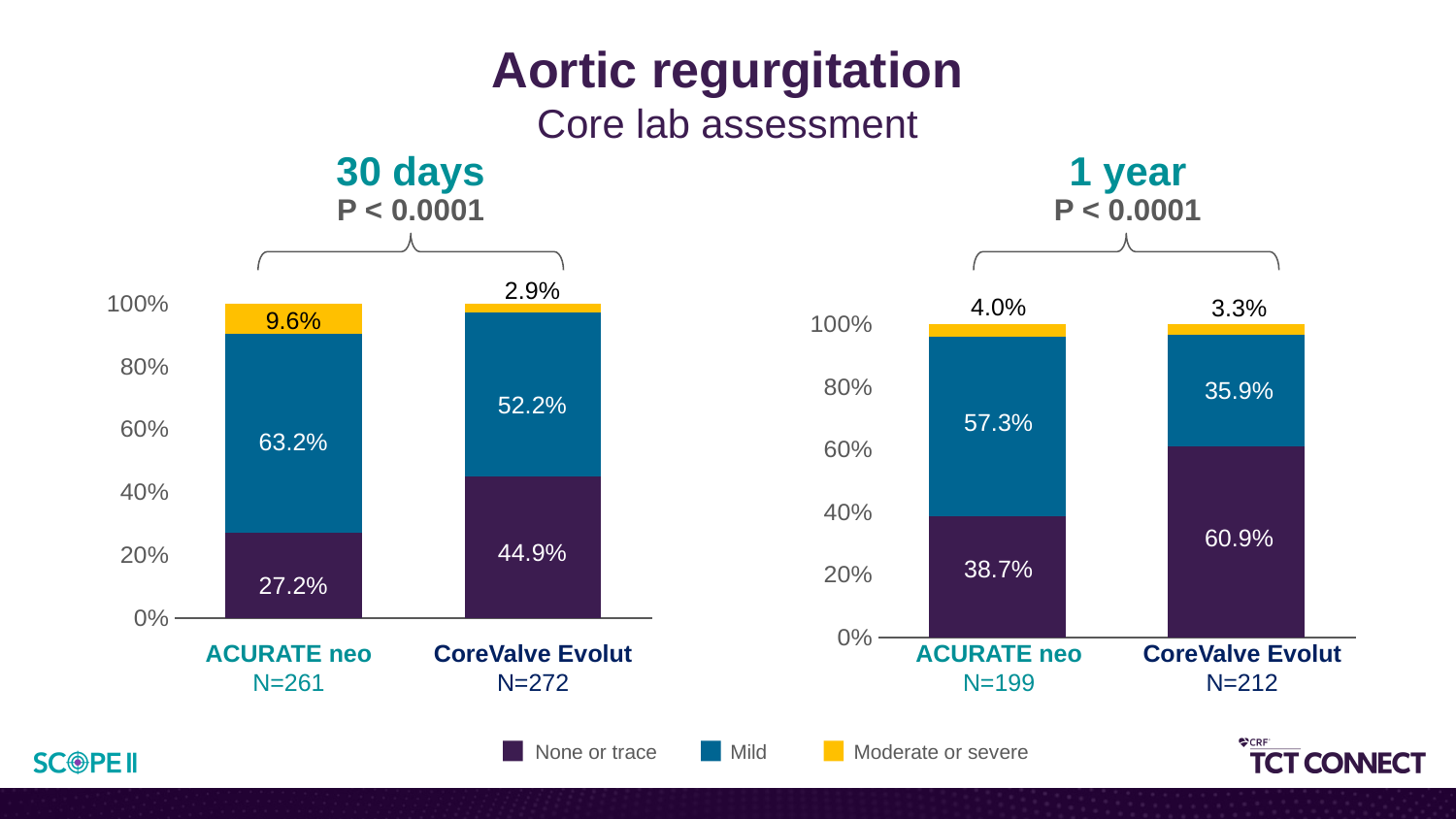
In the 1 year chart, what is the difference between the 'None or trace' values for CoreValve Evolut and ACURATE neo? 22.2% In the 1 year chart, which device has the larger 'None or trace' value, ACURATE neo or CoreValve Evolut? CoreValve Evolut What kind of chart is the 30 days chart? Stacked bar chart In the 1 year chart, what is the 'Moderate or severe' value for ACURATE neo? 4.0% In the 30 days chart, what is the difference between the 'Mild' values for ACURATE neo and CoreValve Evolut? 11.0% In the 30 days chart, which device has the higher 'Moderate or severe' value? ACURATE neo How many series does the legend list? 3 In the 30 days chart, what is the 'Mild' value for CoreValve Evolut? 52.2% In the 1 year chart, is the 'Mild' value for CoreValve Evolut greater or less than 40%? less In the 1 year chart, what is the 'None or trace' value for CoreValve Evolut? 60.9% In the 30 days chart, what is the 'None or trace' value for ACURATE neo? 27.2% What colour represents 'Moderate or severe' in the legend? Yellow